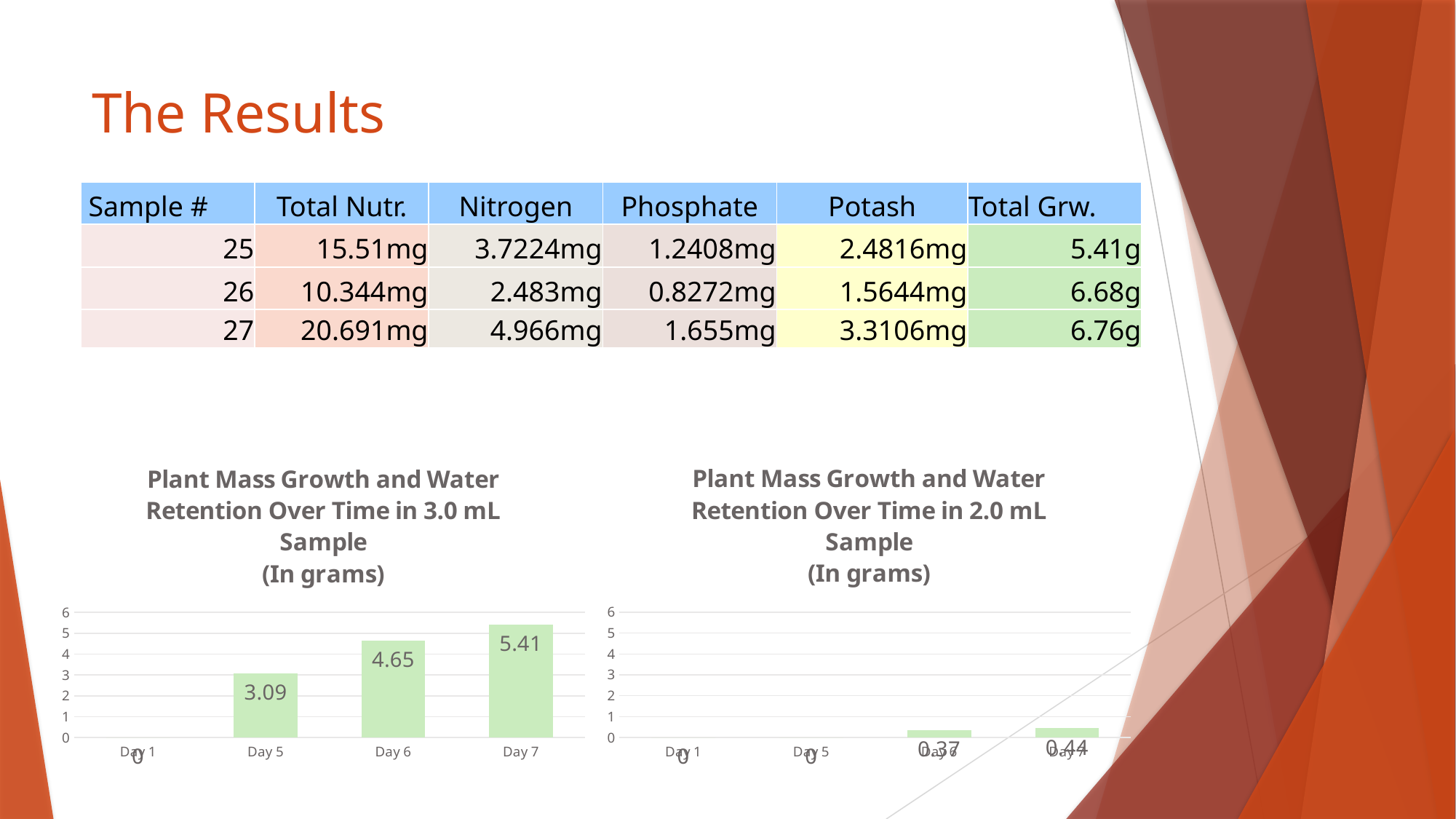
In the 2.0 mL Sample chart, what is the difference between the Day 7 and Day 6 values? 0.07 In the 3.0 mL Sample chart, what is the value for Day 5? 3.09 Which is larger: the Day 6 value in the 3.0 mL Sample chart or the Day 6 value in the 2.0 mL Sample chart? 3.0 mL Sample chart How many days are shown on the x axis of the 3.0 mL Sample chart? 4 What kind of chart is the 2.0 mL Sample chart? Bar chart In the 3.0 mL Sample chart, what is the difference between the Day 7 and Day 6 values? 0.76 In the 3.0 mL Sample chart, which day has the lowest value? Day 1 In the 2.0 mL Sample chart, what is the value for Day 6? 0.37 In the 3.0 mL Sample chart, what is the value for Day 7? 5.41 In the 3.0 mL Sample chart, which day has the highest value? Day 7 In the 3.0 mL Sample chart, do the values rise or fall from Day 1 to Day 7? Rise In the 2.0 mL Sample chart, what is the value for Day 7? 0.44